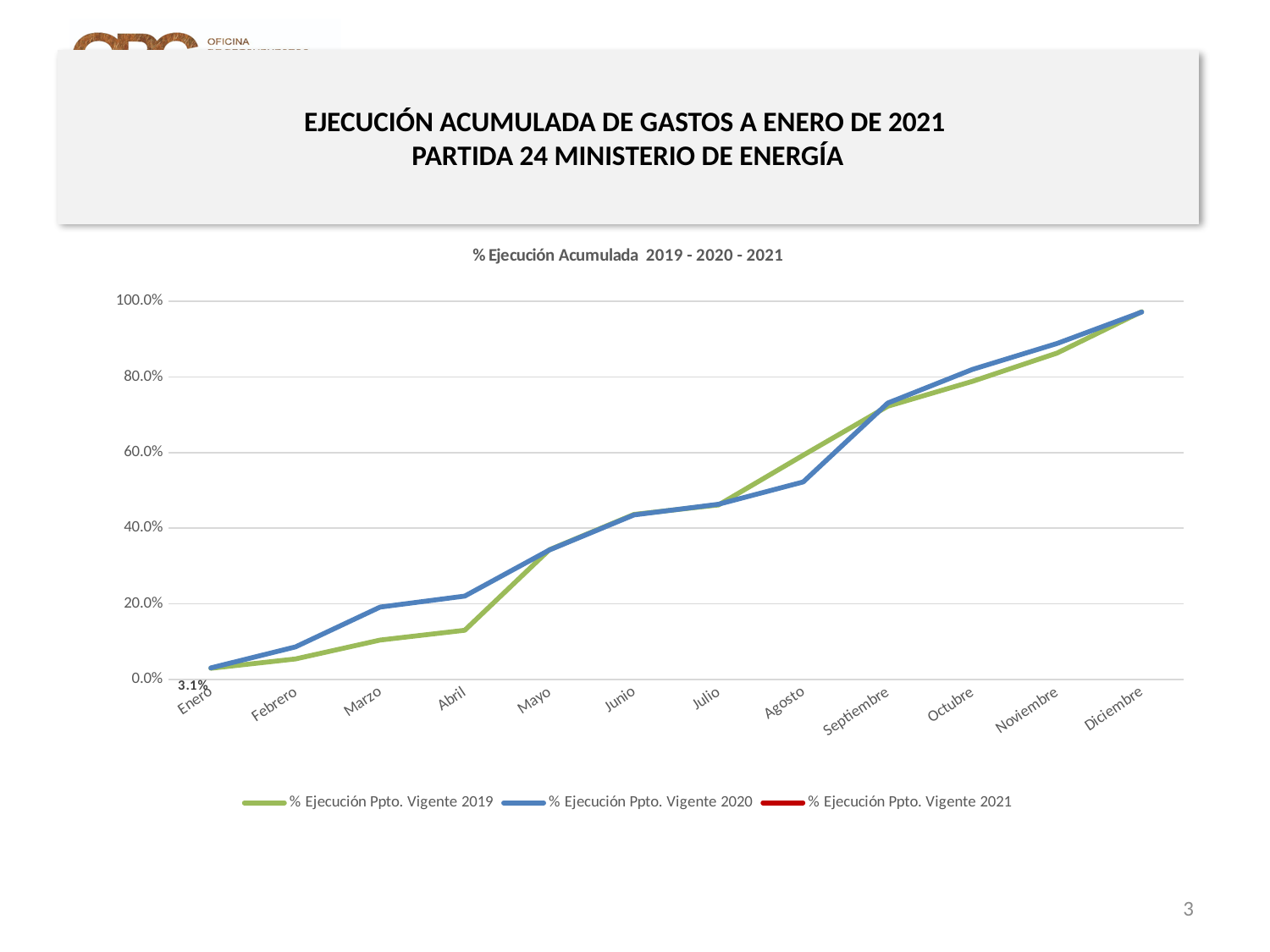
How many months are shown along the x axis of the chart? 12 Is the value for % Ejecución Ppto. Vigente 2019 in Abril greater or less than 20.0%? less In Marzo, which series has the higher value: % Ejecución Ppto. Vigente 2019 or % Ejecución Ppto. Vigente 2020? % Ejecución Ppto. Vigente 2020 How many series does the chart legend list? 3 What type of chart is shown on the slide? line chart What is the value of % Ejecución Ppto. Vigente 2021 in Enero? 3.1% Is the value for % Ejecución Ppto. Vigente 2019 in Noviembre greater or less than 80.0%? greater Do the values for % Ejecución Ppto. Vigente 2020 rise or fall from Enero to Diciembre? rise What is the title of the chart? % Ejecución Acumulada 2019 - 2020 - 2021 Is the value for % Ejecución Ppto. Vigente 2020 in Junio greater or less than 40.0%? greater In Agosto, which series has the higher value: % Ejecución Ppto. Vigente 2019 or % Ejecución Ppto. Vigente 2020? % Ejecución Ppto. Vigente 2019